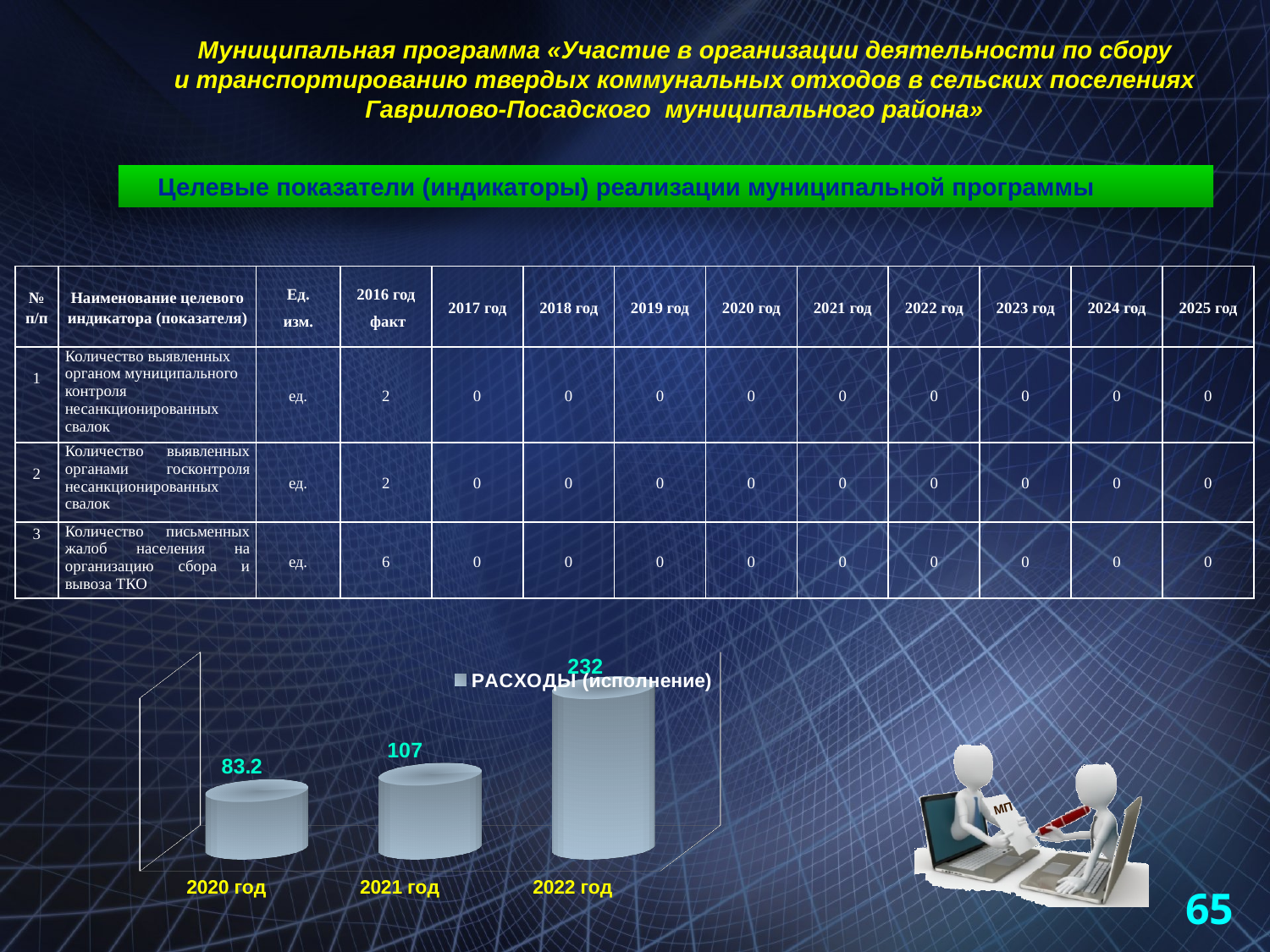
How many categories are shown in the chart? 3 What is the value for 2021 год in the chart? 107 Which year has the highest value in the chart? 2022 год Which year has the lowest value in the chart? 2020 год What is the difference between the values for 2022 год and 2021 год? 125 How many series does the chart legend list? 1 What kind of chart is shown on the slide? Bar chart Do the values rise or fall from 2020 год to 2022 год? Rise What is the difference between the values for 2021 год and 2020 год? 23.8 Which is larger, the value for 2021 год or the value for 2020 год? 2021 год What is the value for 2022 год in the chart? 232 What is the value for 2020 год in the chart? 83.2